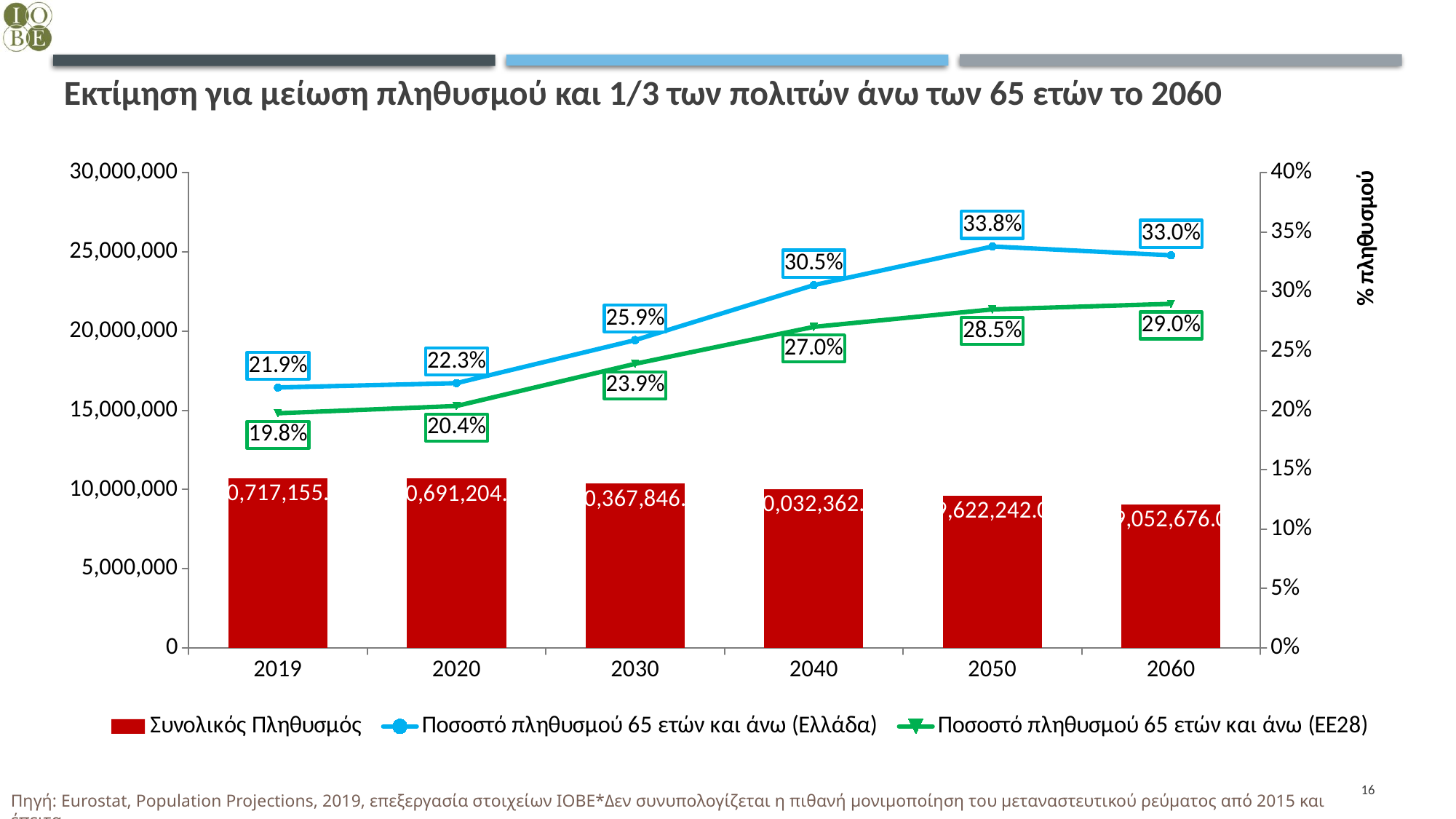
What is the title of the slide containing the chart? Εκτίμηση για μείωση πληθυσμού και 1/3 των πολιτών άνω των 65 ετών το 2060 In which year does the 'Ποσοστό πληθυσμού 65 ετών και άνω (Ελλάδα)' series reach its highest value? 2050 Which is larger in 2030: the Greece share of population aged 65 and over or the EU28 share? Greece (25.9%) What is the difference between the Greece and EU28 shares of population aged 65 and over in 2060? 4.0 percentage points Is the 'Συνολικός Πληθυσμός' bar for 2060 greater or less than 10,000,000? less How many years are shown on the x axis of the chart? 6 How many series does the legend list? 3 What is the value of the 'Ποσοστό πληθυσμού 65 ετών και άνω (Ελλάδα)' series in 2050? 33.8% What is the value of the 'Ποσοστό πληθυσμού 65 ετών και άνω (ΕΕ28)' series in 2040? 27.0% Is the 'Συνολικός Πληθυσμός' bar for 2019 greater or less than 10,000,000? greater In which year is the 'Ποσοστό πληθυσμού 65 ετών και άνω (ΕΕ28)' series lowest? 2019 Do the 'Συνολικός Πληθυσμός' bars rise or fall from 2019 to 2060? fall